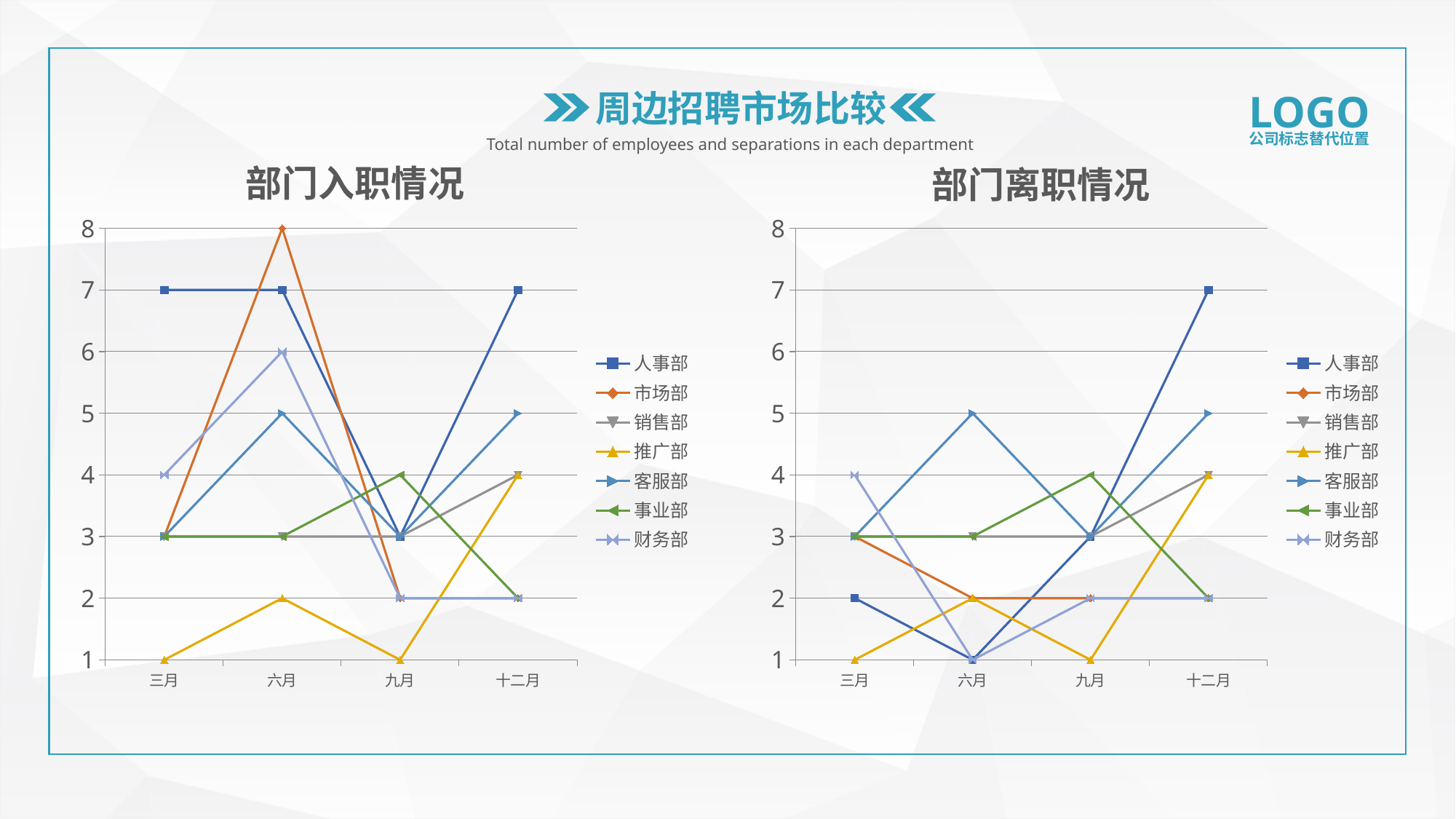
In the 部门入职情况 chart, which series has the lowest value in 三月? 推广部 In the 部门入职情况 chart, which series has the highest value in 六月? 市场部 In the 部门离职情况 chart, which is larger in 六月: 客服部 or 财务部? 客服部 How many series does the legend of the 部门离职情况 chart list? 7 How many x-axis categories does the 部门入职情况 chart have? 4 In the 部门离职情况 chart, does the value for 人事部 rise or fall from 九月 to 十二月? rise In the 部门入职情况 chart, what is the value for 市场部 in 六月? 8 In the 部门离职情况 chart, which series has the highest value in 十二月? 人事部 In the 部门入职情况 chart, what is the difference between 财务部 in 六月 and 财务部 in 九月? 4 What kind of chart is the 部门入职情况 chart? line chart In the 部门入职情况 chart, what is the value for 人事部 in 九月? 3 In the 部门离职情况 chart, what is the value for 人事部 in 十二月? 7